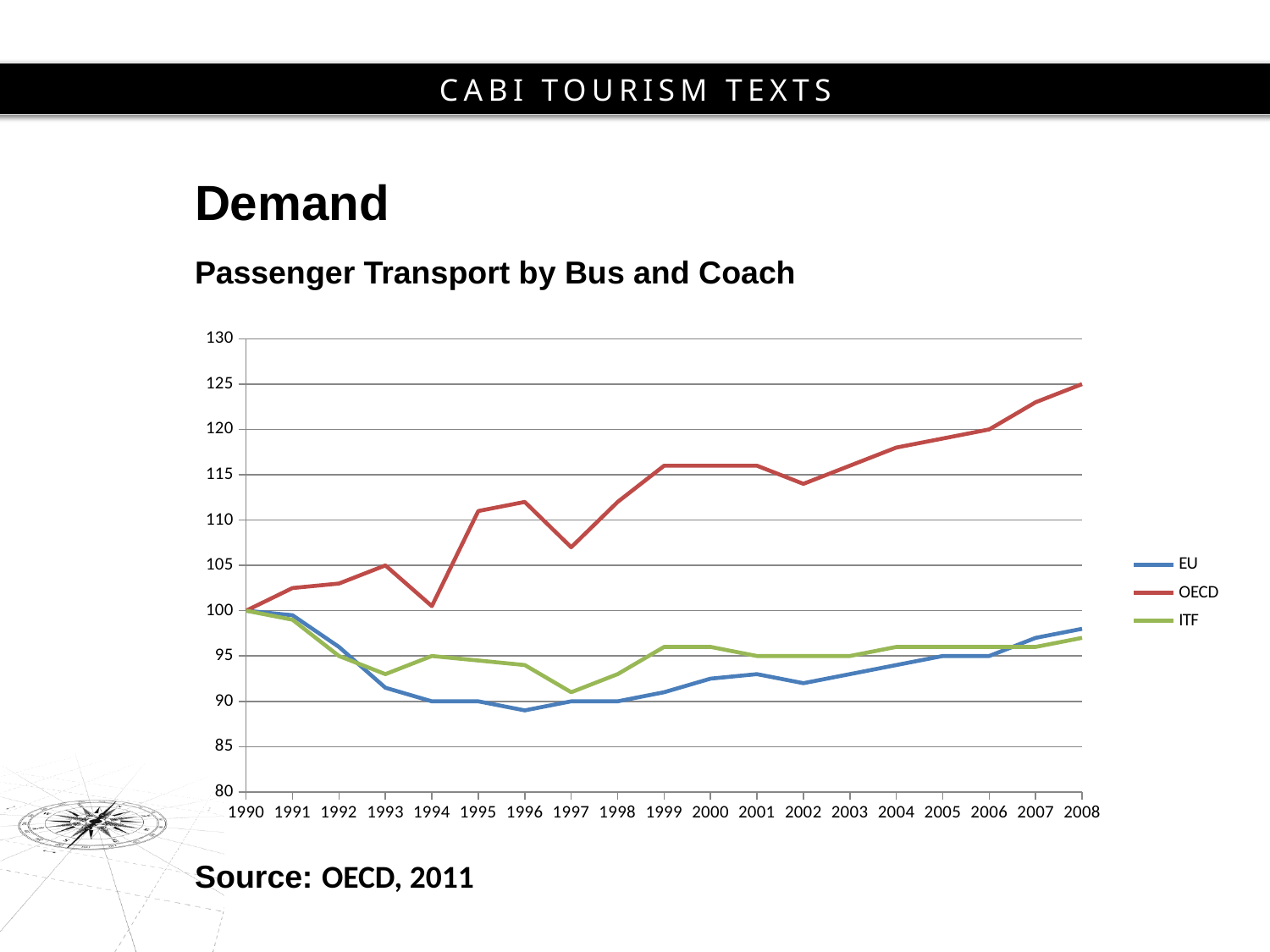
How many years are plotted along the x axis? 19 Is the value for ITF in 1997 greater or less than 95? less What kind of chart is shown on the slide? line chart What is the value for OECD in 2006? 120 What is the value for OECD in 2008? 125 Which series has the highest value in 2008? OECD What is the value for all three series in 1990? 100 How many series does the legend list? 3 What is the value for EU in 1994? 90 Does the OECD series generally rise or fall from 1990 to 2008? rise Which series has the lowest value in 1996? EU Is the value for OECD in 1997 greater or less than 110? less